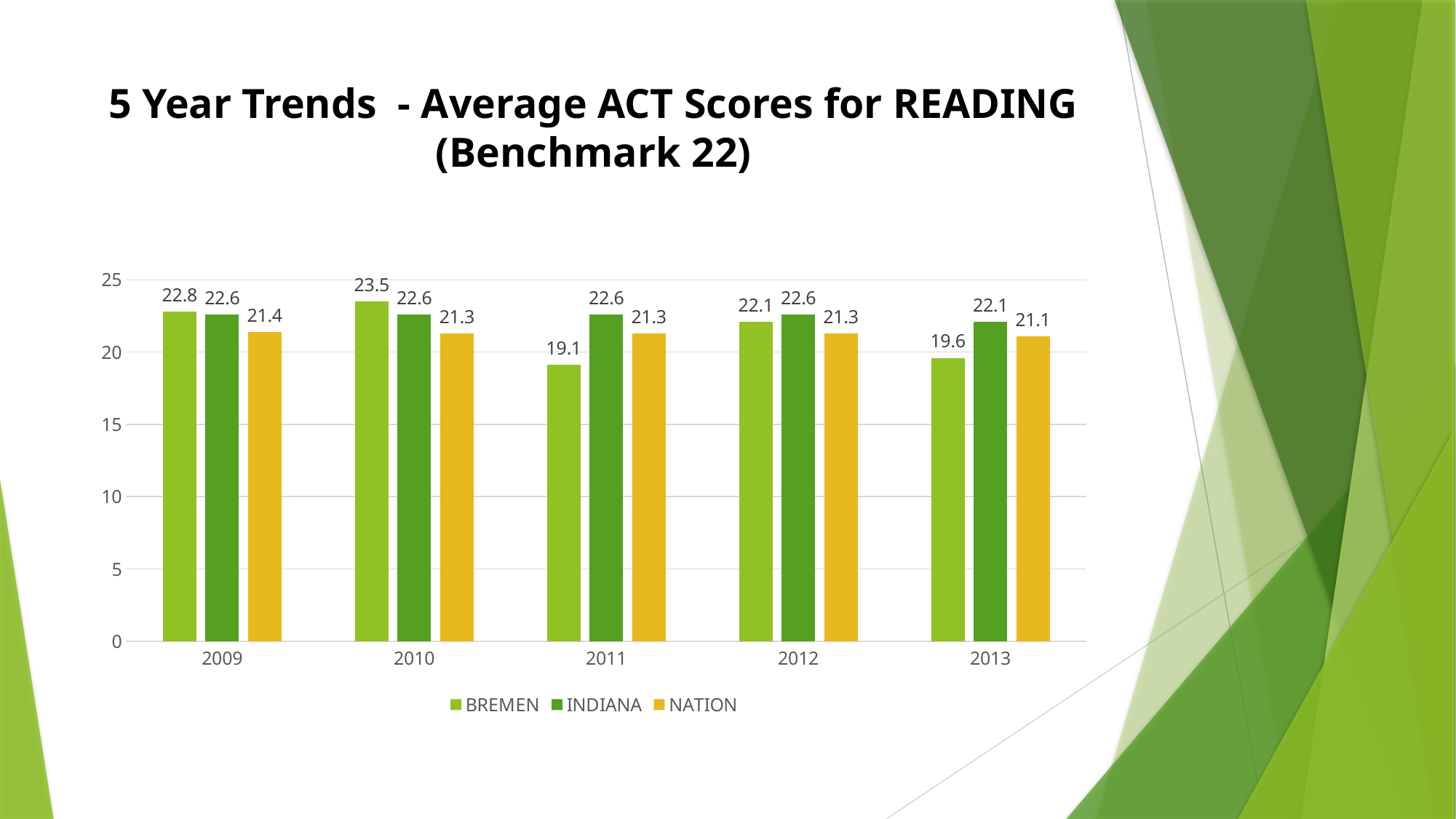
How many series does the legend list? 3 What was the BREMEN average ACT reading score in 2010? 23.5 Did the NATION score rise or fall from 2009 to 2013? Fall Which was higher in 2009, BREMEN or NATION? BREMEN What kind of chart is shown on the slide? Bar chart What was the NATION average ACT reading score in 2013? 21.1 What was the INDIANA average ACT reading score in 2012? 22.6 What is the difference between the BREMEN and INDIANA scores in 2011? 3.5 How many years are shown on the x axis? 5 Which was higher in 2013, INDIANA or BREMEN? INDIANA In which year was the BREMEN score the lowest? 2011 In which year was the BREMEN score the highest? 2010